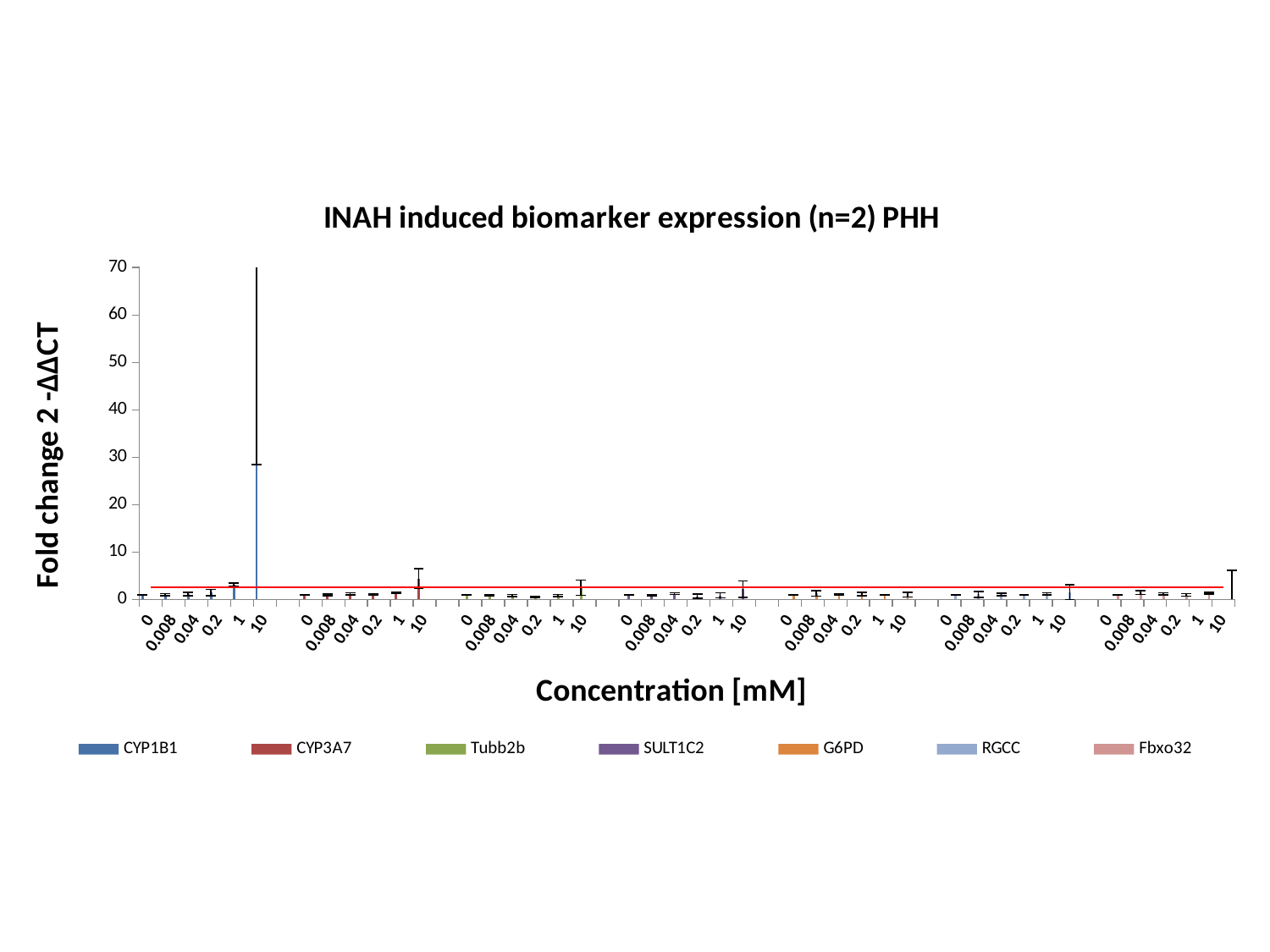
What kind of chart is shown on the slide? bar chart Is the value for CYP3A7 at concentration 10 greater or less than 10? less How many series does the legend list? 7 What is the label of the x axis? Concentration [mM] Which series has the tallest bar in the chart? CYP1B1 Which is larger, the value for CYP1B1 at concentration 10 or the value for CYP3A7 at concentration 10? CYP1B1 at concentration 10 How many concentration levels are plotted for each series? 6 What is the title of the chart? INAH induced biomarker expression (n=2) PHH Is the value for CYP1B1 at concentration 10 greater or less than 20? greater What is the highest value shown on the y axis? 70 At which concentration does the CYP1B1 series reach its highest value? 10